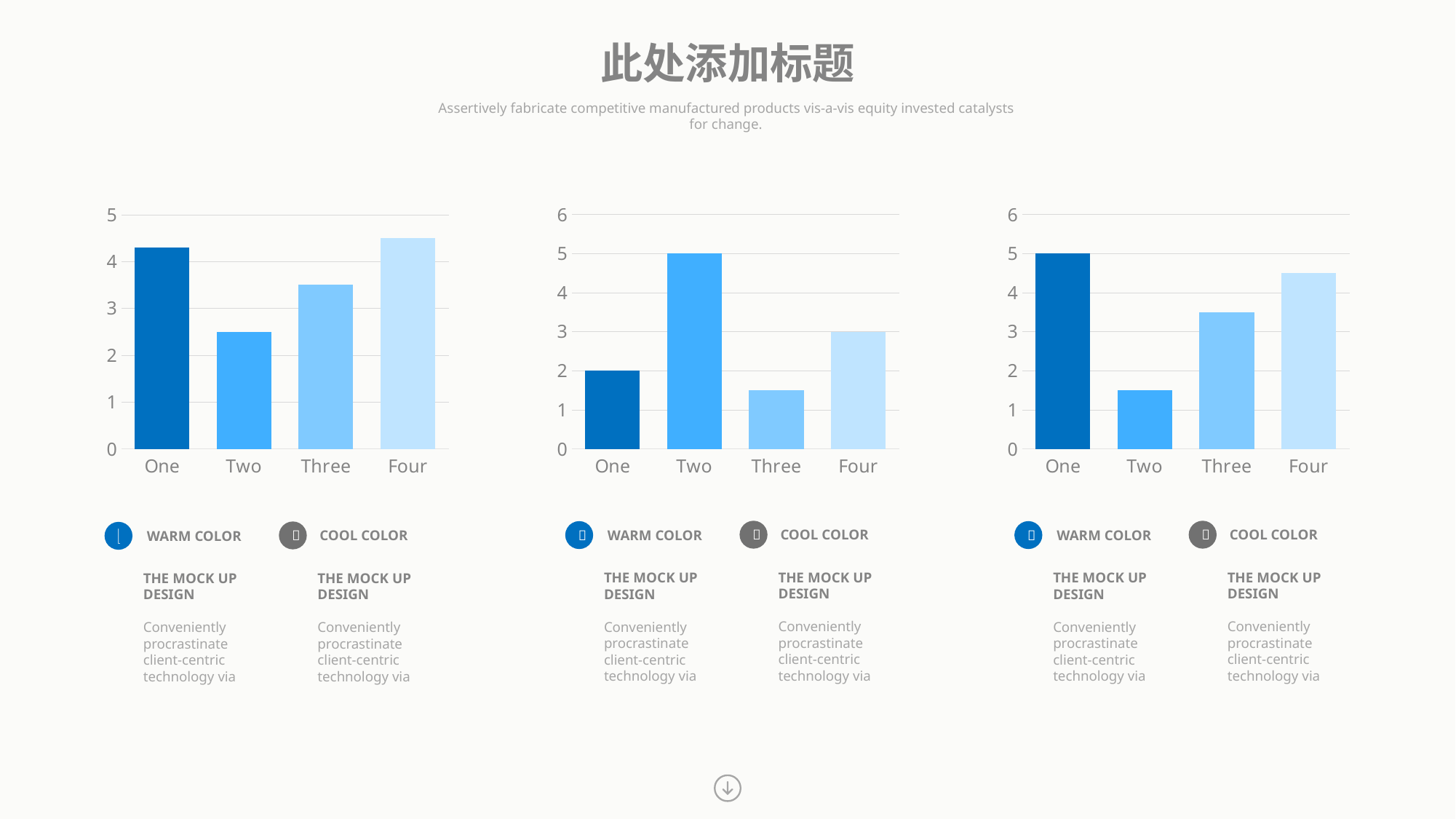
In the middle chart, what is the value for One? 2 In the middle chart, what is the difference between the values for Two and One? 3 In the right chart, which category has the lowest value? Two How many categories does the middle chart show on its x axis? 4 In the right chart, what is the value for One? 5 In the middle chart, what is the value for Two? 5 What kind of chart is the left chart on the slide? bar chart In the left chart, which category has the lowest value? Two In the middle chart, what is the value for Four? 3 In the right chart, is the value for Four greater or less than 4? greater In the left chart, is the value for Three greater or less than 3? greater In the middle chart, which category has the lowest value? Three